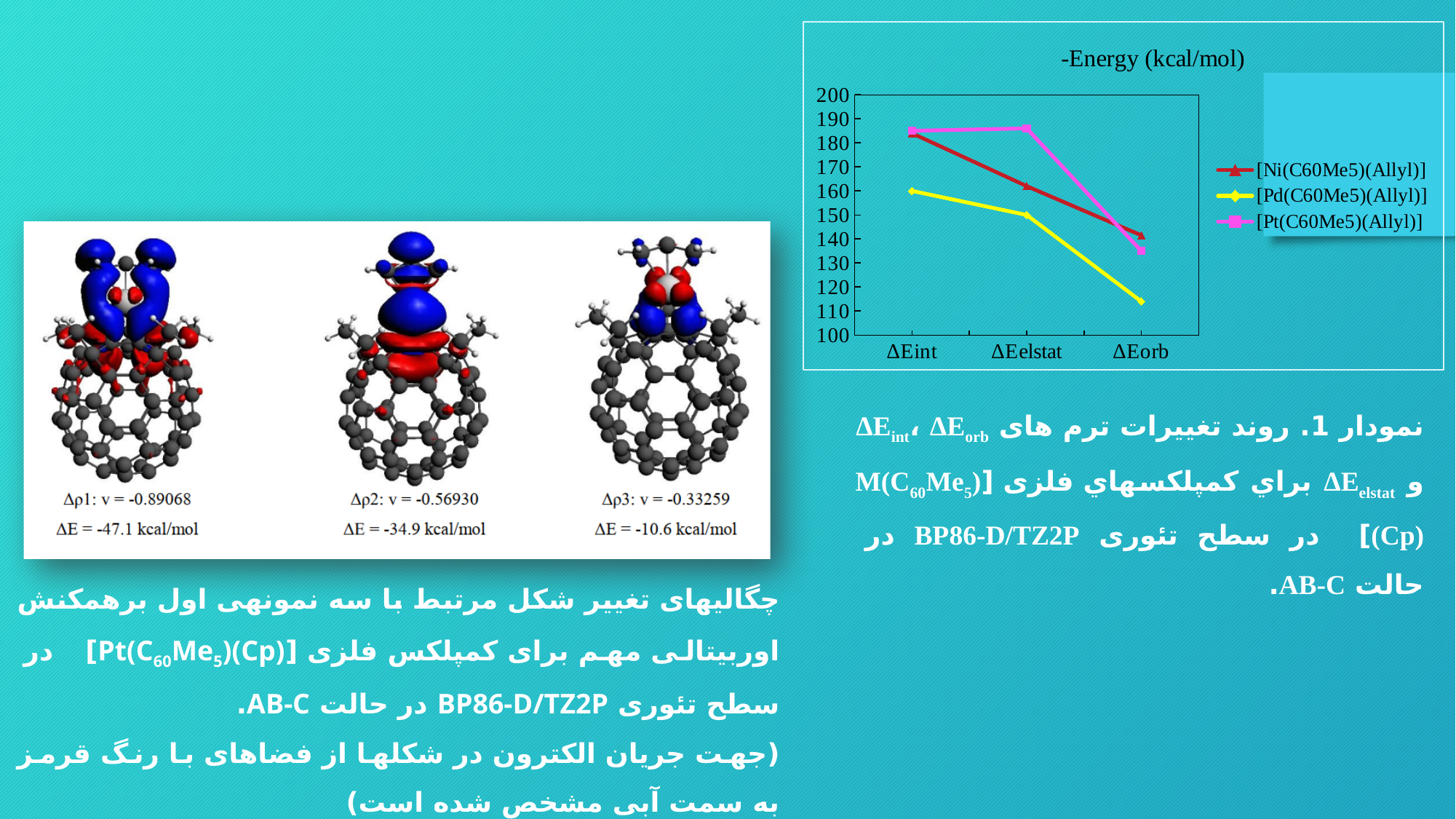
What is the title of the chart? -Energy (kcal/mol) Which series in the chart is drawn in yellow? [Pd(C60Me5)(Allyl)] At ΔEorb, which is larger: the value for [Ni(C60Me5)(Allyl)] or for [Pd(C60Me5)(Allyl)]? [Ni(C60Me5)(Allyl)] Is the value for [Pt(C60Me5)(Allyl)] at ΔEelstat greater or less than 180? greater Which series has the highest value at ΔEelstat? [Pt(C60Me5)(Allyl)] Which series has the lowest value at ΔEorb? [Pd(C60Me5)(Allyl)] Is the value for [Pd(C60Me5)(Allyl)] at ΔEorb greater or less than 120? less Do the values for the [Pd(C60Me5)(Allyl)] series rise or fall from ΔEint to ΔEorb? fall How many series does the chart legend list? 3 Is the value for [Pd(C60Me5)(Allyl)] at ΔEint greater or less than 170? less What kind of chart is shown on the slide? line chart How many categories are shown on the x axis of the chart? 3